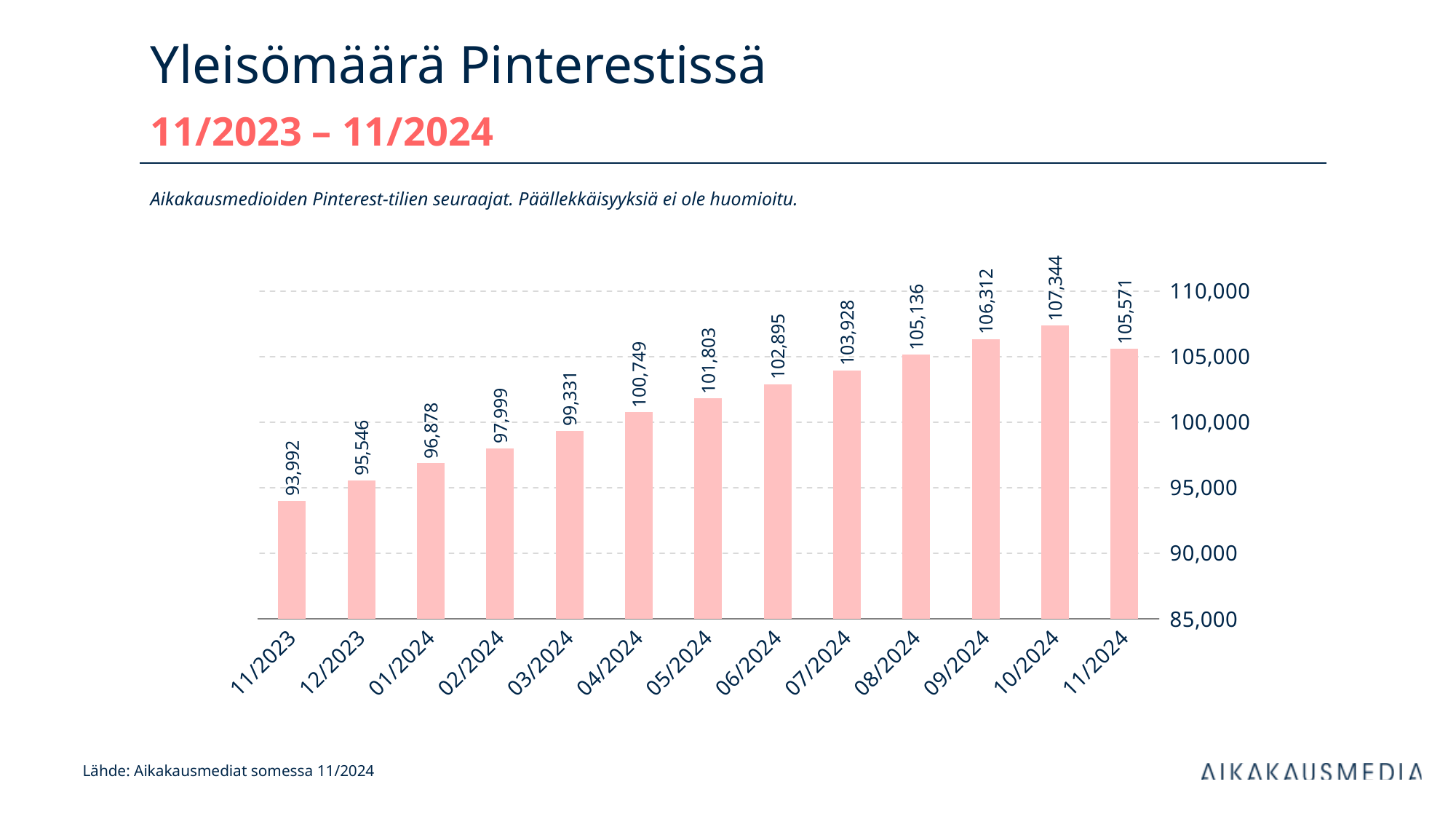
Which month has the highest value? 10/2024 Do the values generally rise or fall from 11/2023 to 10/2024? rise How many months are shown on the x axis? 13 Is the value for 03/2024 greater or less than 100,000? less What is the difference between the values for 10/2024 and 11/2024? 1,773 What is the value for 11/2023? 93,992 What is the value for 11/2024? 105,571 Which is larger, the value for 09/2024 or the value for 11/2024? 09/2024 What kind of chart is shown on the slide? bar chart What is the difference between the values for 10/2024 and 11/2023? 13,352 What is the value for 06/2024? 102,895 Which month has the lowest value? 11/2023